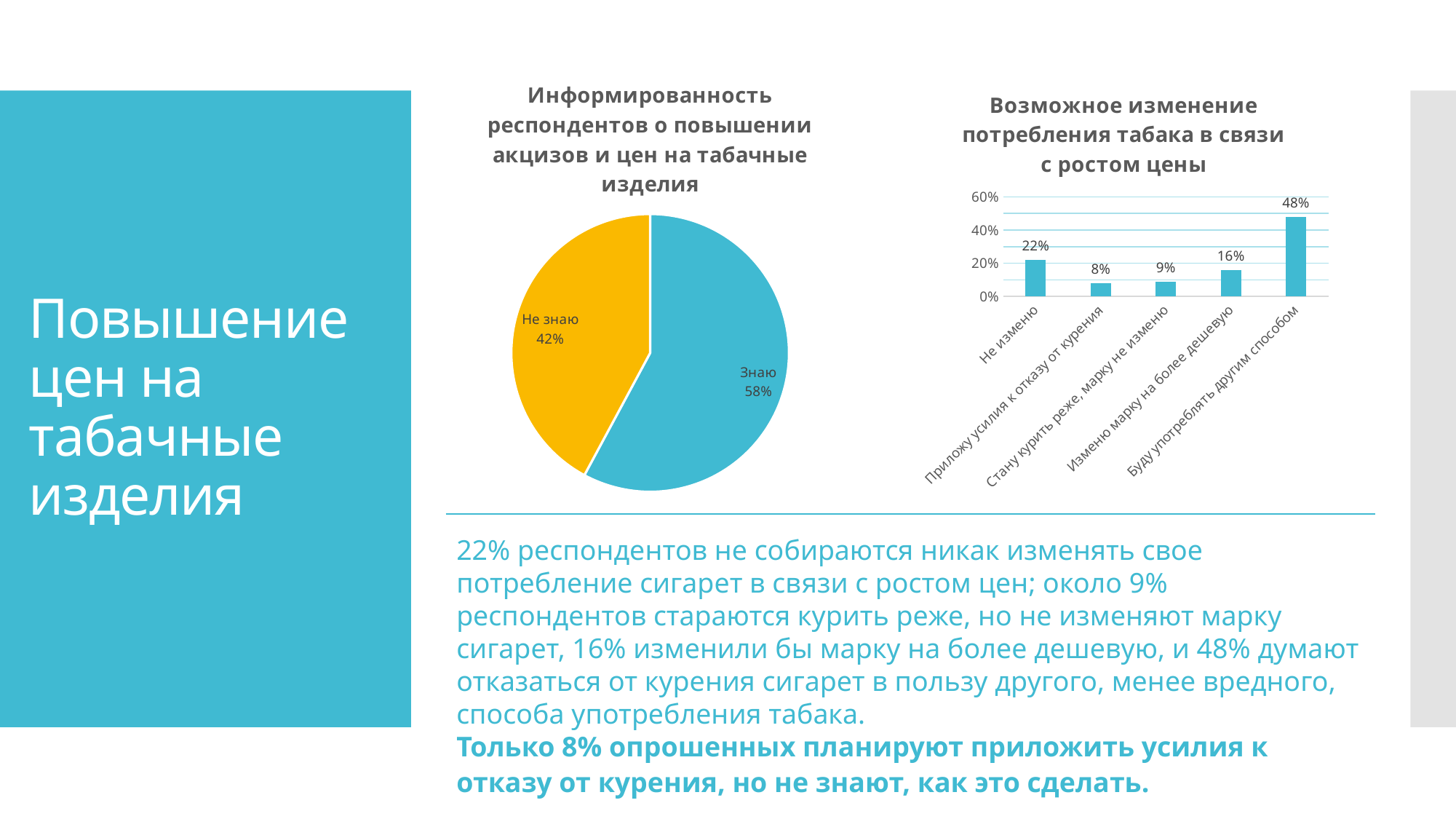
In the bar chart "Возможное изменение потребления табака в связи с ростом цены", what is the value for "Не изменю"? 22% In the pie chart on the left, which slice is larger, "Знаю" or "Не знаю"? Знаю In the bar chart "Возможное изменение потребления табака в связи с ростом цены", is the value for "Буду употреблять другим способом" greater or less than 40%? greater In the pie chart on the left, how many slices are there? 2 In the bar chart "Возможное изменение потребления табака в связи с ростом цены", which category has the highest value? Буду употреблять другим способом In the bar chart "Возможное изменение потребления табака в связи с ростом цены", how many categories are shown? 5 In the bar chart "Возможное изменение потребления табака в связи с ростом цены", which category has the lowest value? Приложу усилия к отказу от курения In the bar chart "Возможное изменение потребления табака в связи с ростом цены", what is the difference between "Буду употреблять другим способом" and "Не изменю"? 26% What type of chart is the chart on the right of the slide? Bar chart In the pie chart on the left, what share of respondents answered "Не знаю"? 42% In the pie chart on the left, what share of respondents answered "Знаю"? 58% In the bar chart "Возможное изменение потребления табака в связи с ростом цены", what is the value for "Изменю марку на более дешевую"? 16%